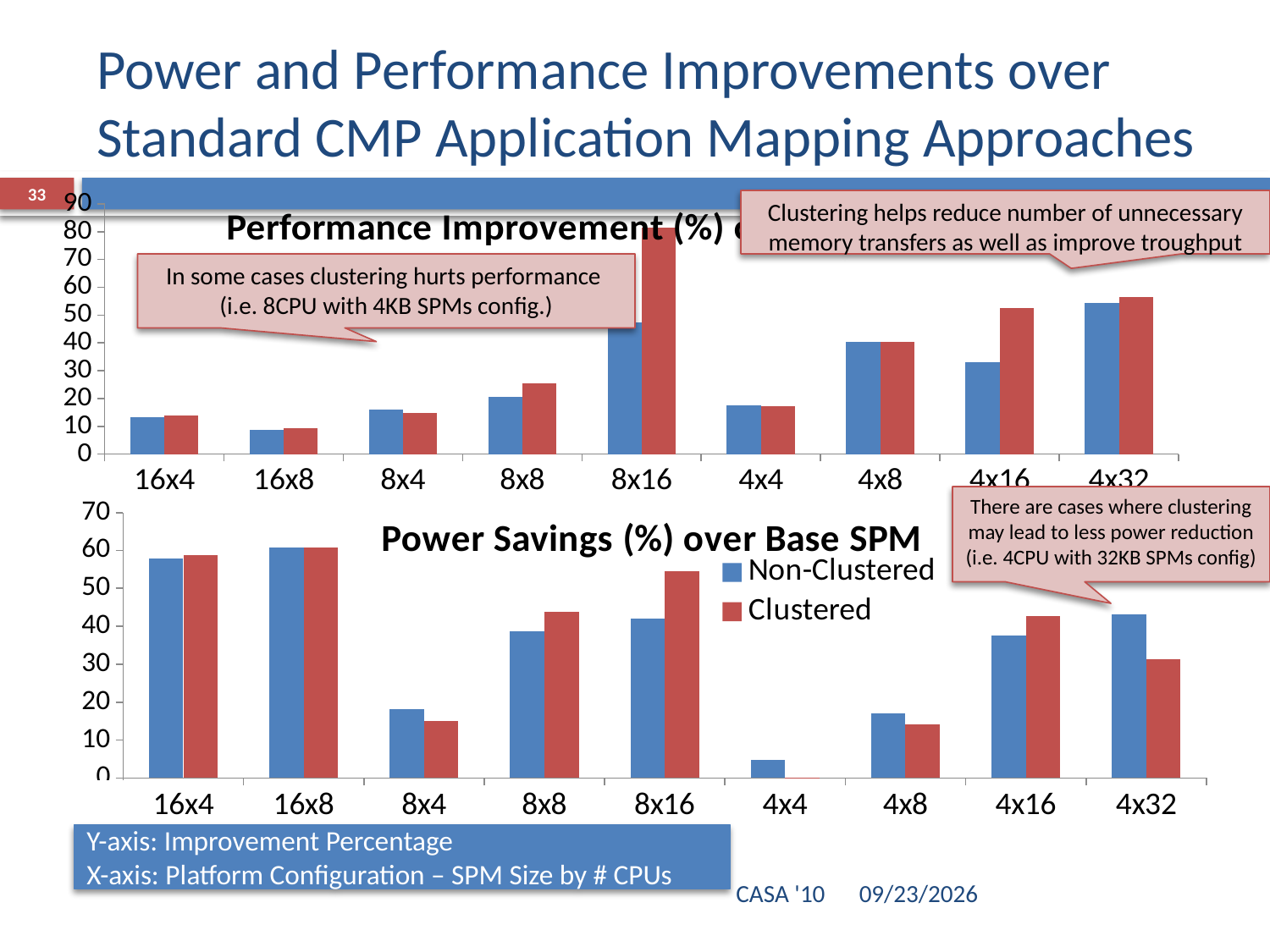
In the Power Savings (%) over Base SPM chart, which is larger for 4x32: the Non-Clustered or the Clustered value? Non-Clustered How many platform configurations are shown on the x axis of the Performance Improvement (%) chart? 9 In the Performance Improvement (%) chart, which is larger for 4x16: the Non-Clustered or the Clustered value? Clustered In the Performance Improvement (%) chart, is the Non-Clustered value for 4x4 greater or less than 20? less In the Performance Improvement (%) chart, is the Clustered value for 8x16 greater or less than 70? greater In the Power Savings (%) over Base SPM chart, is the Clustered value for 8x16 greater or less than 50? greater Which colour represents the Clustered series in the charts? red How many series does the legend list for the Power Savings (%) over Base SPM chart? 2 In the Performance Improvement (%) chart, which configuration has the highest Clustered value? 8x16 What type of chart is the Power Savings (%) over Base SPM chart? bar chart In the Power Savings (%) over Base SPM chart, which configuration has the lowest Non-Clustered value? 4x4